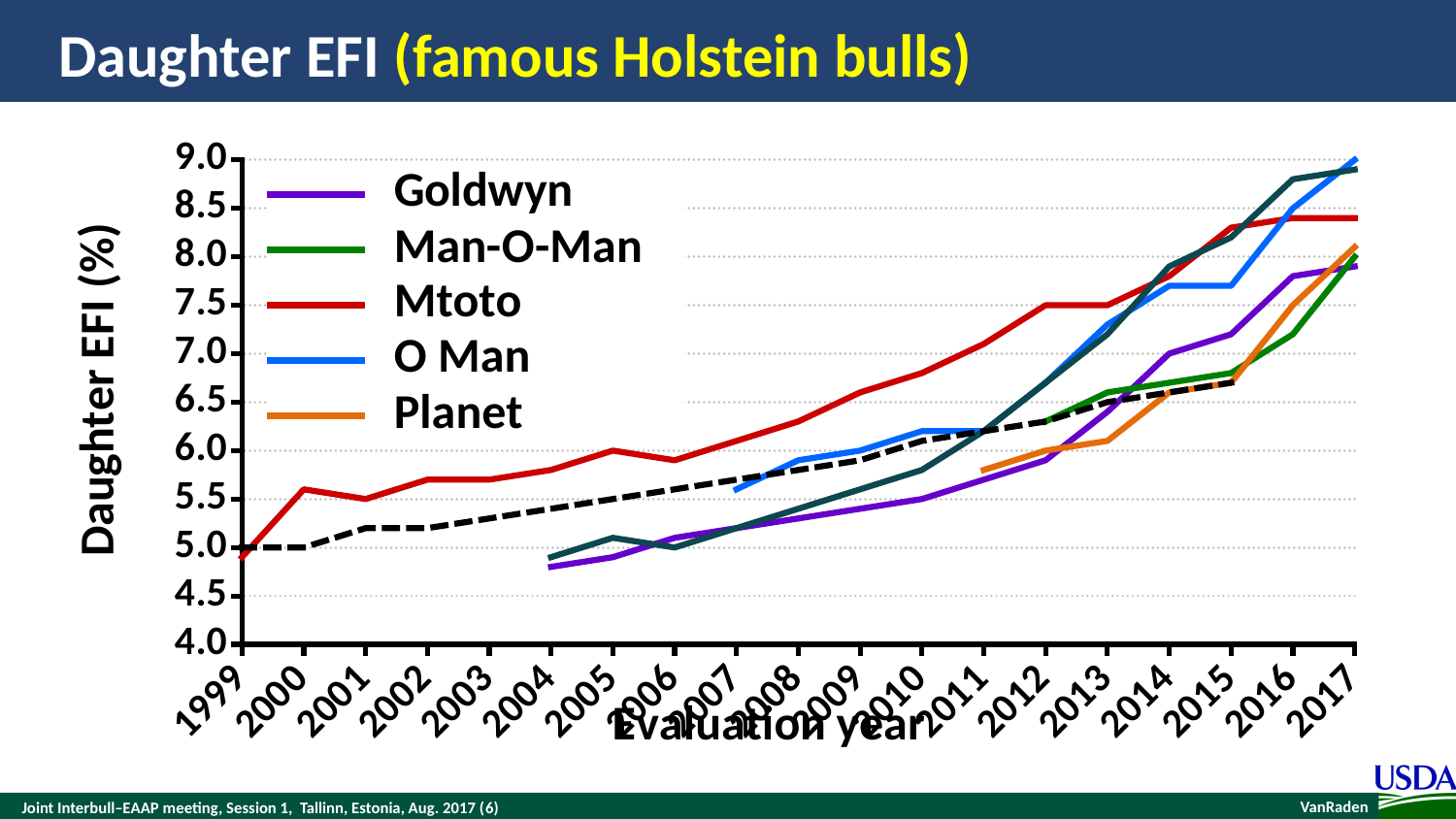
How many evaluation years are shown on the x axis? 19 Which is larger in 2010, the Daughter EFI for Mtoto or for O Man? Mtoto Is the Daughter EFI for Goldwyn in 2004 greater or less than 5.0? less Does the Daughter EFI for Mtoto rise or fall from 1999 to 2017? rise How many series does the legend list? 5 Which bull has the highest Daughter EFI in 2017? O Man What kind of chart is shown on the slide? line chart What is the title of the x axis? Evaluation year Is the Daughter EFI for Mtoto in 2017 greater or less than 8.0? greater Is the Daughter EFI for Planet in 2011 greater or less than 5.5? greater Which bull's line starts earliest on the x axis? Mtoto